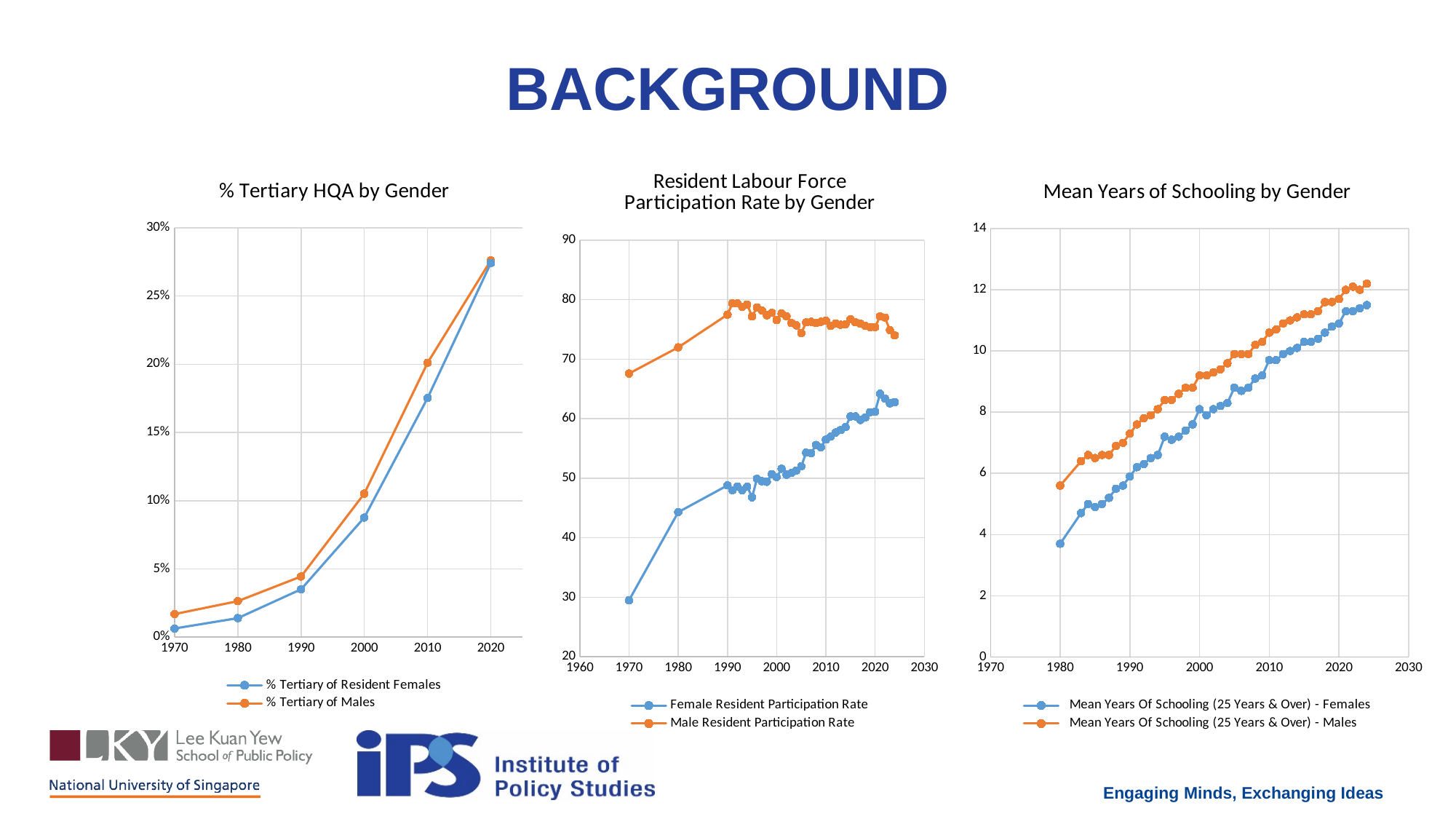
In the 'Resident Labour Force Participation Rate by Gender' chart, is the 'Male Resident Participation Rate' in 1990 greater or less than 70? greater How many series does the legend of the 'Resident Labour Force Participation Rate by Gender' chart list? 2 In the 'Resident Labour Force Participation Rate by Gender' chart, is the 'Female Resident Participation Rate' in 1970 greater or less than 40? less In the 'Mean Years of Schooling by Gender' chart, is the value for females in 1980 greater or less than 4? less In the 'Mean Years of Schooling by Gender' chart, which colour is used for the 'Mean Years Of Schooling (25 Years & Over) - Males' series? orange What kind of chart is the '% Tertiary HQA by Gender' chart? line chart In the '% Tertiary HQA by Gender' chart, how many data points are plotted for the '% Tertiary of Males' series? 6 In the '% Tertiary HQA by Gender' chart, do the values for '% Tertiary of Resident Females' rise or fall from 1970 to 2020? rise In the 'Resident Labour Force Participation Rate by Gender' chart, which series is higher in 2010, the male or the female participation rate? Male Resident Participation Rate In the '% Tertiary HQA by Gender' chart, which series has the higher value in 2010, '% Tertiary of Males' or '% Tertiary of Resident Females'? % Tertiary of Males